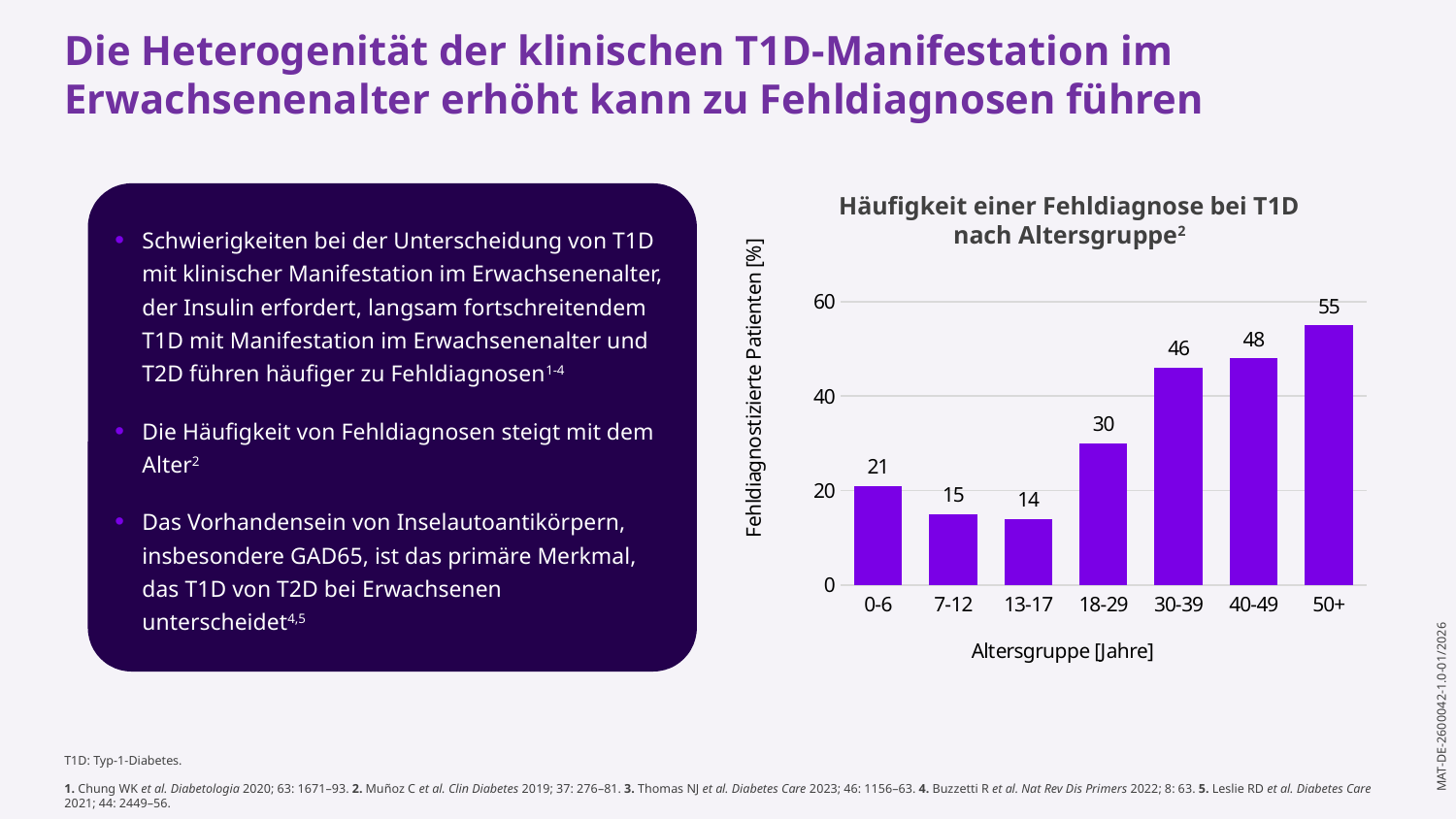
Which age group has the lowest value? 13-17 Which is larger, the value for 7-12 or the value for 18-29? 18-29 What is the difference between the values for 50+ and 0-6? 34 What is the value for the 0-6 age group? 21 What is the value for the 30-39 age group? 46 How many age groups are shown on the x axis? 7 What kind of chart is shown? Bar chart What is the value for the 13-17 age group? 14 What is the difference between the values for 40-49 and 18-29? 18 Is the value for 30-39 greater or less than 40? greater Which age group has the highest value? 50+ What is the label of the y axis? Fehldiagnostizierte Patienten [%]